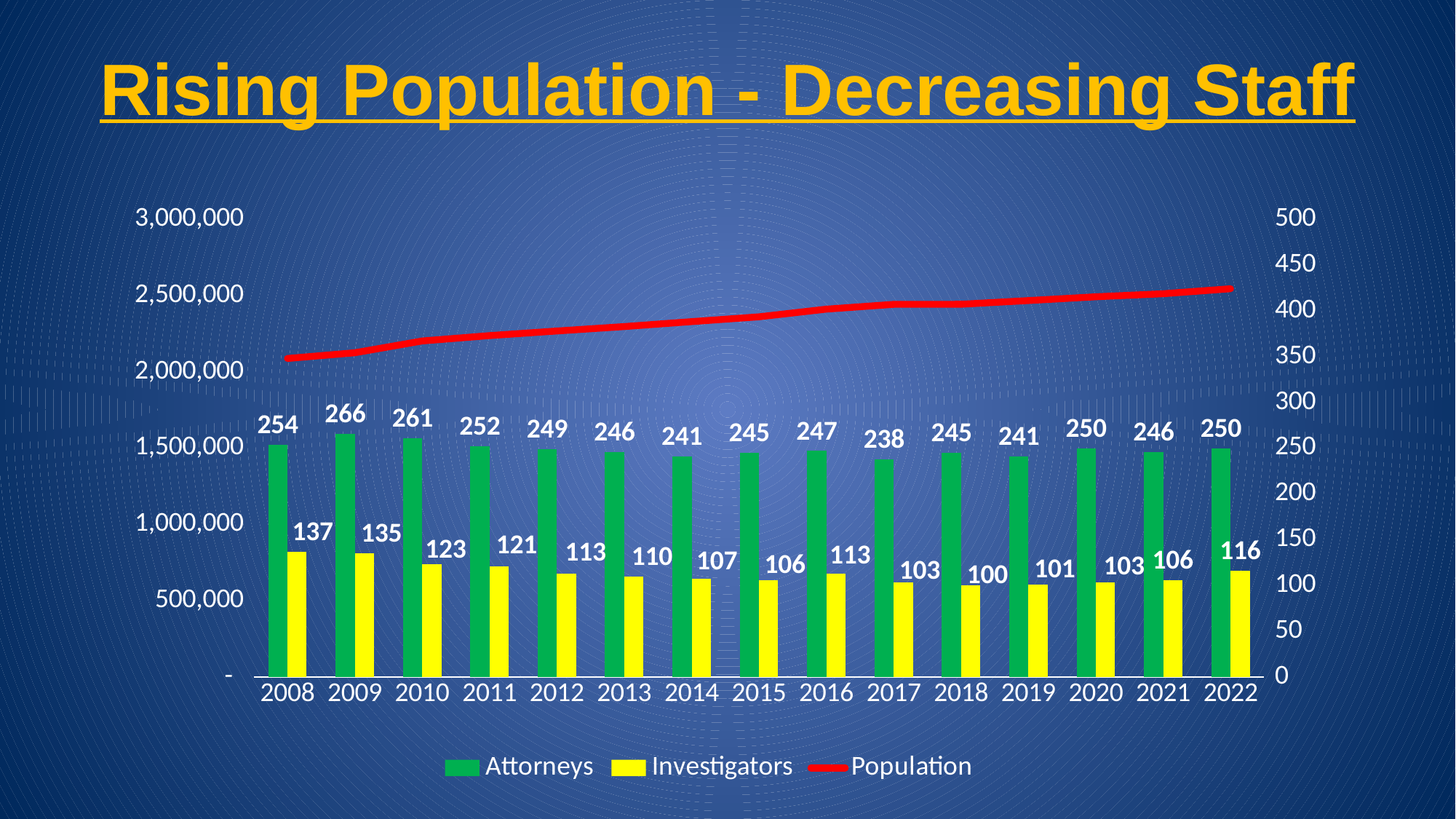
How many years are shown on the x axis? 15 Does the Population line rise or fall from 2008 to 2022? rise What is the Attorneys value for 2017? 238 How many Attorneys were there in 2009? 266 What is the difference between the Investigators values in 2008 and 2022? 21 What kind of chart is this? Combination bar and line chart Is the Population value for 2008 greater or less than 2,500,000? less How many series does the legend list? 3 In which year is the Investigators value lowest? 2018 What is the value for Investigators in 2018? 100 Which year has the larger Attorneys value, 2010 or 2011? 2010 In which year is the Attorneys value highest? 2009